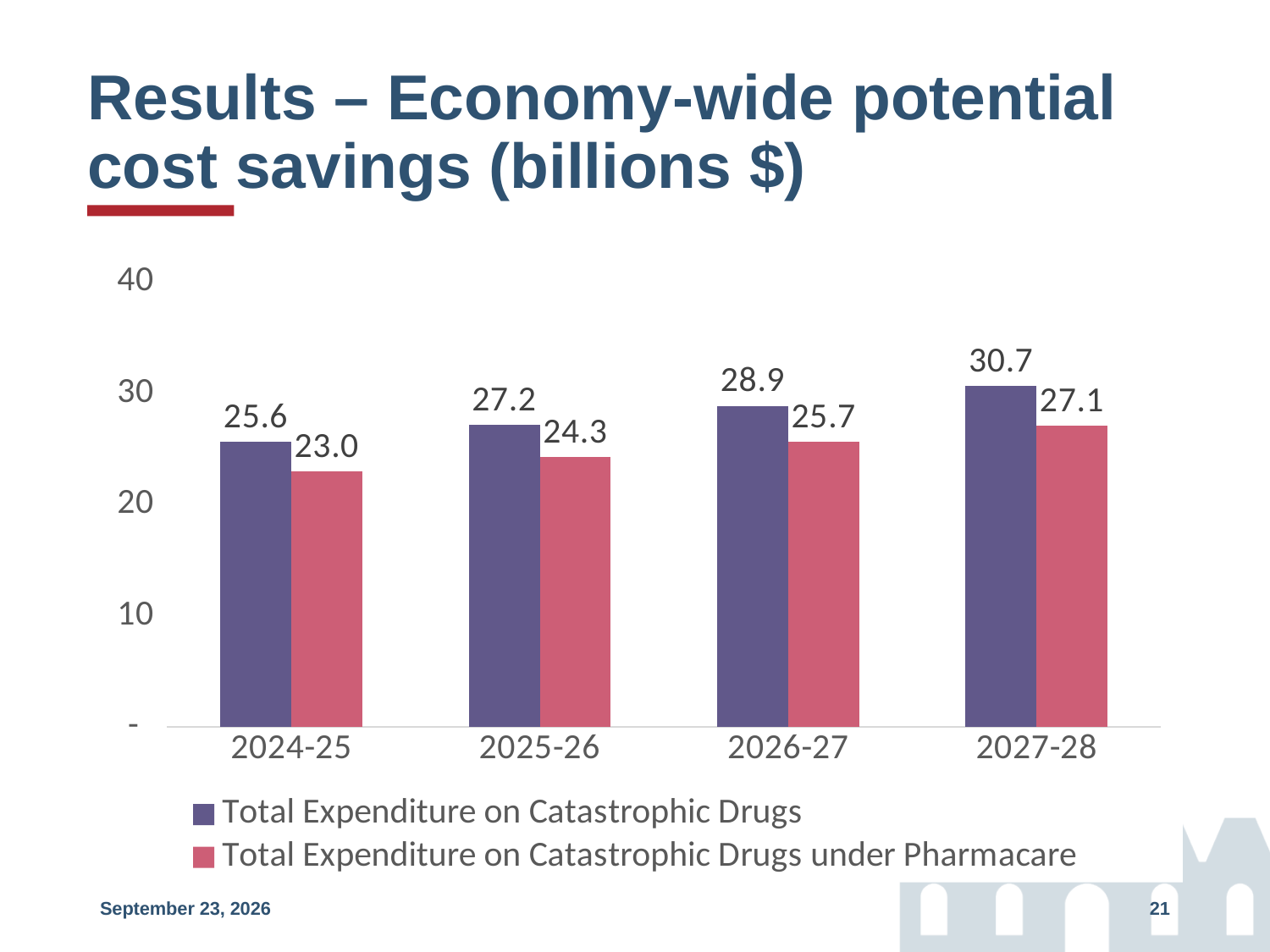
What is the Total Expenditure on Catastrophic Drugs for 2027-28? 30.7 What is the difference between Total Expenditure on Catastrophic Drugs and Total Expenditure on Catastrophic Drugs under Pharmacare in 2027-28? 3.6 What is the Total Expenditure on Catastrophic Drugs under Pharmacare for 2026-27? 25.7 How many series does the legend list? 2 How many years are shown on the x axis? 4 What is the Total Expenditure on Catastrophic Drugs for 2024-25? 25.6 What kind of chart is shown on the slide? Bar chart Do the values for Total Expenditure on Catastrophic Drugs rise or fall from 2024-25 to 2027-28? Rise Which year has the highest Total Expenditure on Catastrophic Drugs under Pharmacare? 2027-28 Is the Total Expenditure on Catastrophic Drugs for 2027-28 greater or less than 30? greater Which is larger in 2025-26: Total Expenditure on Catastrophic Drugs or Total Expenditure on Catastrophic Drugs under Pharmacare? Total Expenditure on Catastrophic Drugs Which year has the lowest Total Expenditure on Catastrophic Drugs? 2024-25